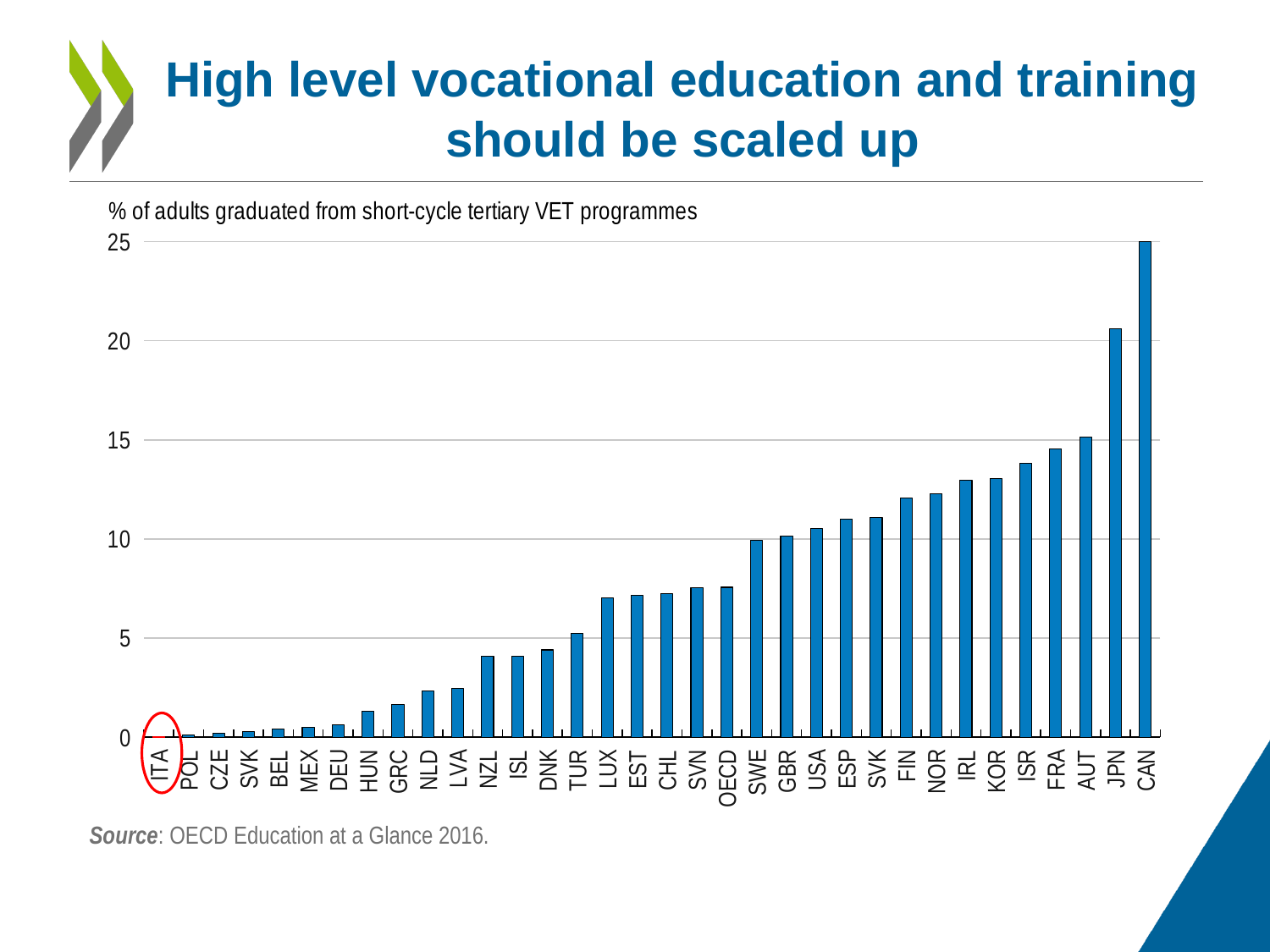
Is the value for JPN greater or less than 20? greater Do the bar values rise or fall from left to right along the x axis? rise Is the value for OECD greater or less than 10? less Which country has the highest share of adults graduated from short-cycle tertiary VET programmes? CAN Which is larger, the value for JPN or the value for AUT? JPN What kind of chart is shown on the slide? bar chart Which country label is circled in red on the chart? ITA Is the value for FRA greater or less than 15? less Which is larger, the value for NLD or the value for DEU? NLD